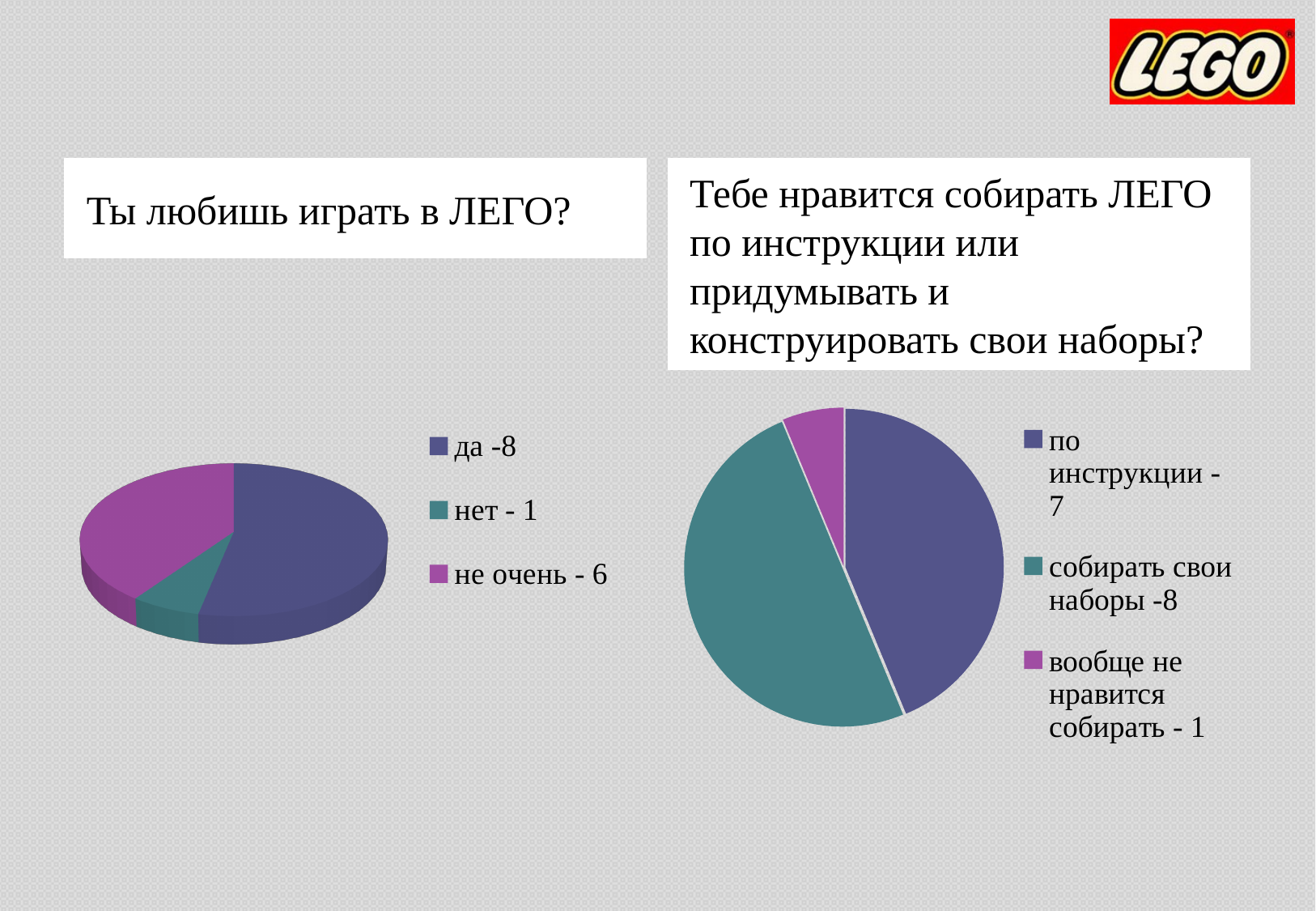
In the left chart 'Ты любишь играть в ЛЕГО?', what is the difference between the 'да' and 'не очень' counts? 2 In the left chart 'Ты любишь играть в ЛЕГО?', how many answer categories does the legend list? 3 What type of chart is the left chart 'Ты любишь играть в ЛЕГО?'? pie chart In the right chart about building LEGO by instructions or own sets, what share of the pie does 'собирать свои наборы' represent? 50% In the right chart about building LEGO by instructions or own sets, how many respondents chose 'по инструкции'? 7 In the left chart 'Ты любишь играть в ЛЕГО?', how many respondents answered 'не очень'? 6 In the right chart about building LEGO by instructions or own sets, what colour is the 'вообще не нравится собирать' slice? purple In the left chart 'Ты любишь играть в ЛЕГО?', how many respondents answered 'да'? 8 In the left chart 'Ты любишь играть в ЛЕГО?', which answer has the smallest slice? нет In the right chart about building LEGO by instructions or own sets, which is larger: 'по инструкции' or 'собирать свои наборы'? собирать свои наборы In the right chart about building LEGO by instructions or own sets, what is the total number of respondents across all slices? 16 In the right chart about building LEGO by instructions or own sets, which answer has the largest slice? собирать свои наборы